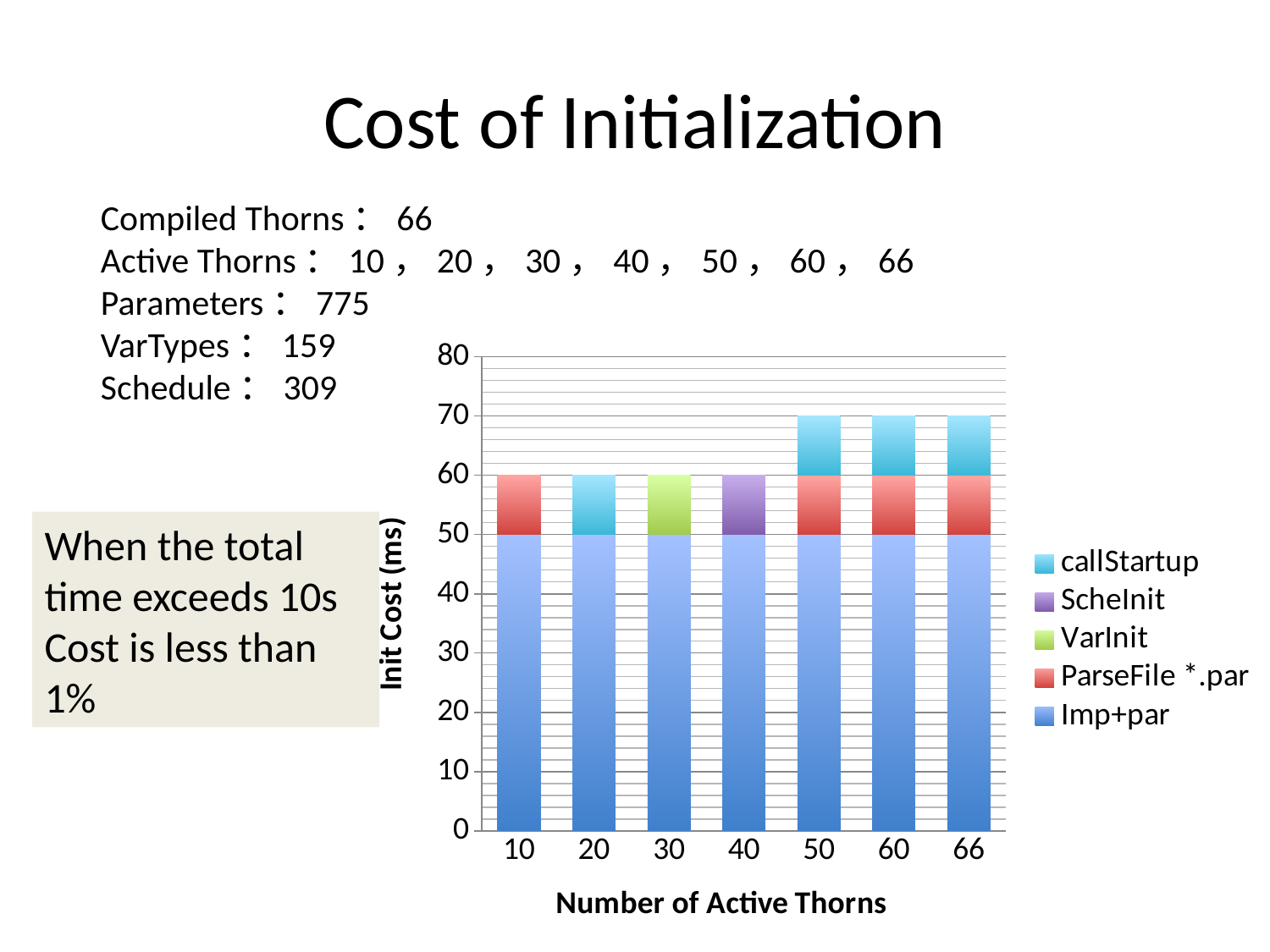
Which is larger, the total init cost for 20 active thorns or for 60 active thorns? 60 active thorns What is the total init cost for 10 active thorns? 60 What is the Imp+par value for 40 active thorns? 50 What kind of chart is shown on the slide? stacked bar chart What is the difference between the total init cost for 60 active thorns and for 40 active thorns? 10 Is the total init cost for 30 active thorns greater or less than 70? less How many series does the legend list? 5 What is the total init cost for 66 active thorns? 70 What is the label of the y axis? Init Cost (ms) Is the total init cost for 50 active thorns greater or less than 60? greater How many categories are shown on the x axis? 7 Which legend entry is shown in green? VarInit